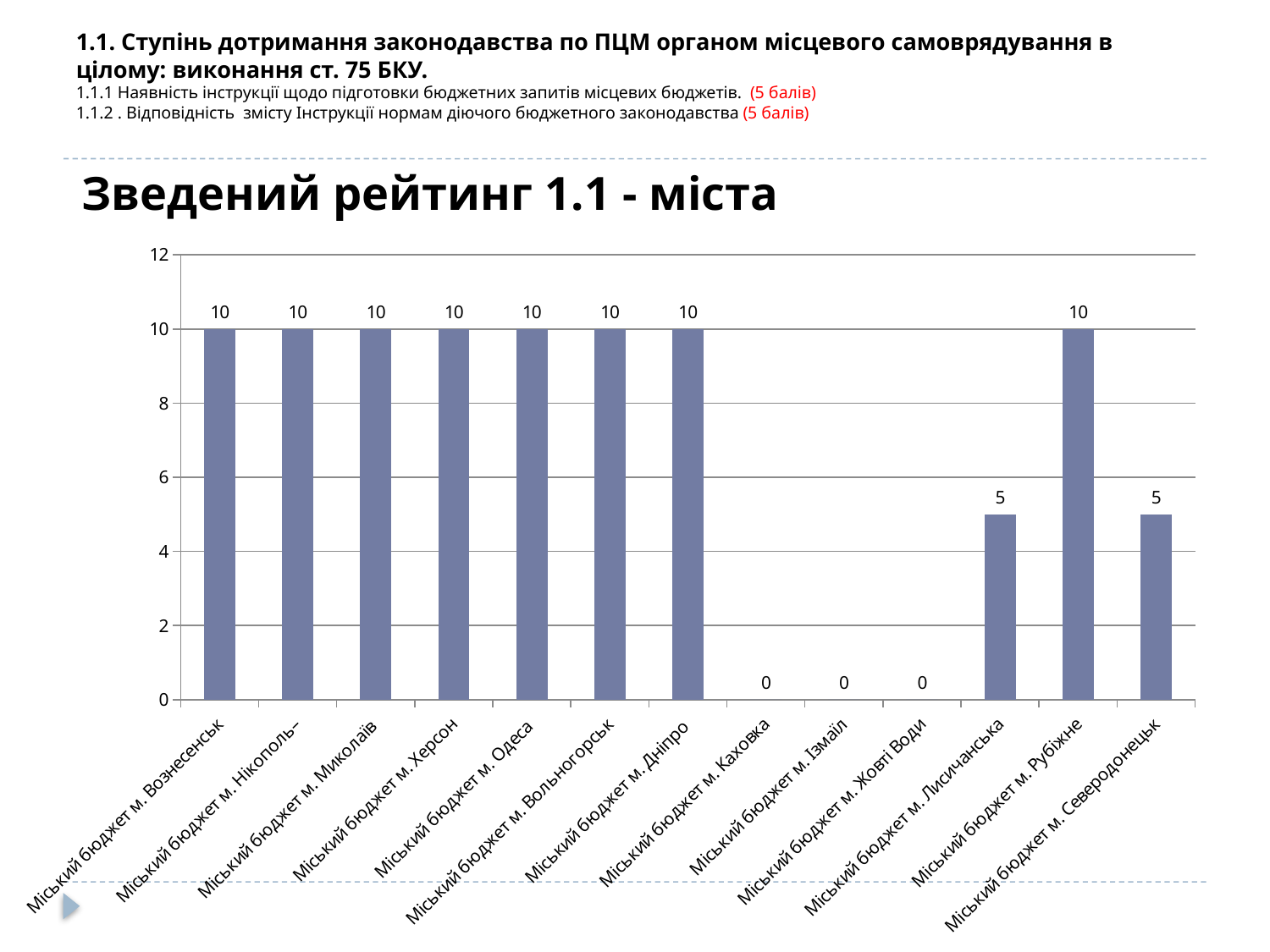
What is the value for Міський бюджет м. Каховка? 0 How many categories have a value of 0? 3 How many categories are shown on the x axis? 13 What is the value for Міський бюджет м. Рубіжне? 10 What kind of chart is shown on the slide? bar chart What is the highest value shown on the y axis? 12 Which is larger, the value for Міський бюджет м. Херсон or the value for Міський бюджет м. Ізмаїл? Міський бюджет м. Херсон What is the value for Міський бюджет м. Лисичанська? 5 What is the value for Міський бюджет м. Одеса? 10 What is the difference between the values for Міський бюджет м. Дніпро and Міський бюджет м. Лисичанська? 5 What is the title of the chart? Зведений рейтинг 1.1 - міста What is the value for Міський бюджет м. Северодонецьк? 5